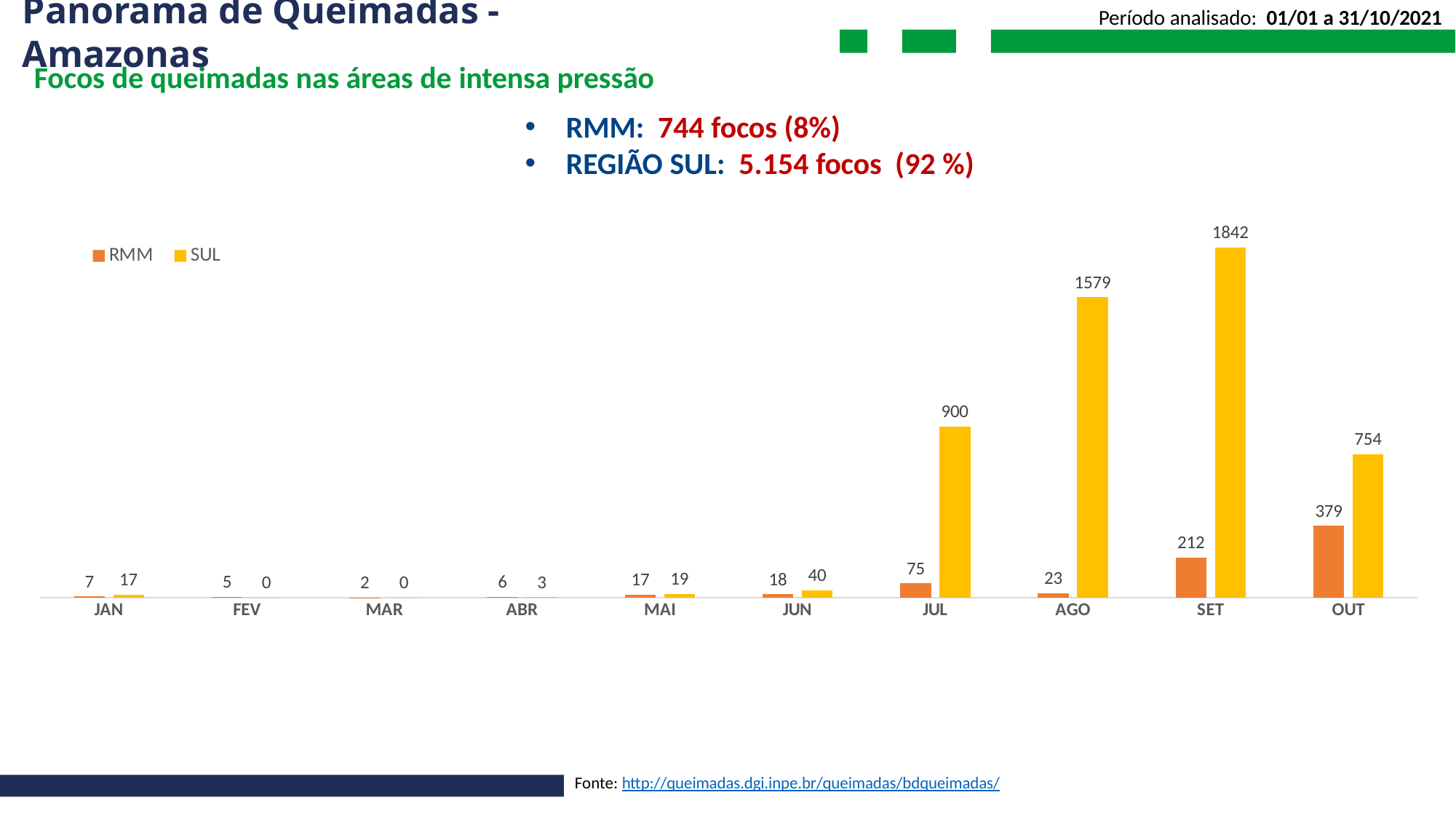
Which month has the lowest RMM value? MAR Which is larger, the RMM value for SET or the RMM value for OUT? OUT What is the SUL value for JUL? 900 What kind of chart is shown on the slide? Bar chart What is the SUL value for SET? 1842 What is the difference between the SUL values for SET and AGO? 263 Which month has the highest SUL value? SET Which series is shown in yellow in the legend? SUL How many months are shown on the x axis? 10 What is the RMM value for AGO? 23 How many series does the legend list? 2 What is the RMM value for OUT? 379